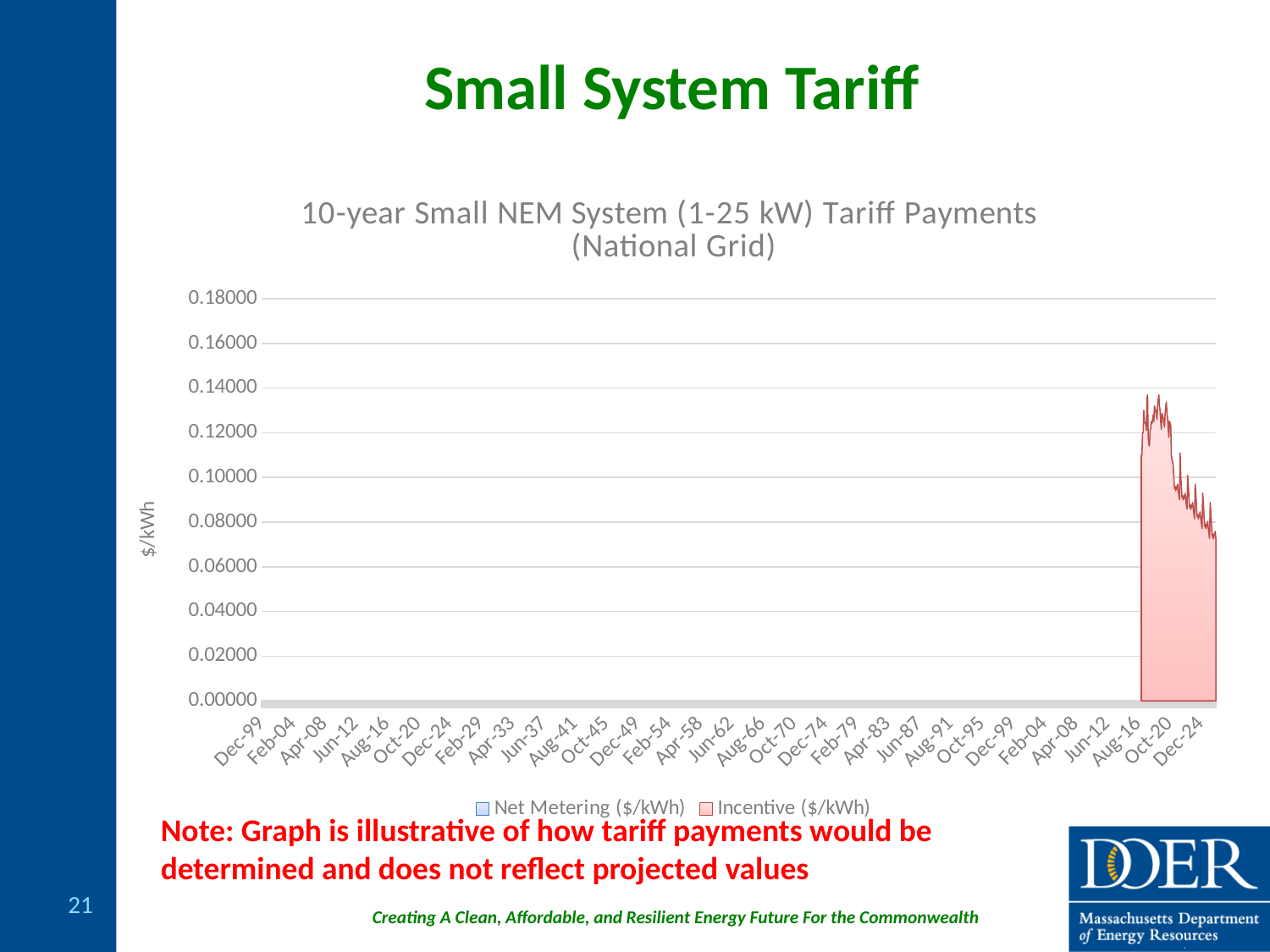
Is the Incentive ($/kWh) value at the right-hand end of the chart greater or less than 0.06000? greater What is the label on the chart's vertical axis? $/kWh What kind of chart is shown on the slide? Area chart Is the highest value reached by the Incentive ($/kWh) series greater or less than 0.12000? greater What are the two series named in the chart legend? Net Metering ($/kWh) and Incentive ($/kWh) What is the title of the chart? 10-year Small NEM System (1-25 kW) Tariff Payments (National Grid) How many series does the chart legend list? 2 After reaching its peak, does the Incentive ($/kWh) series generally rise or fall toward the right end of the chart? fall Is the Incentive ($/kWh) value at the right-hand end of the chart greater or less than 0.10000? less What is the highest value shown on the vertical axis? 0.18000 Which series is plotted with the red shaded area? Incentive ($/kWh)